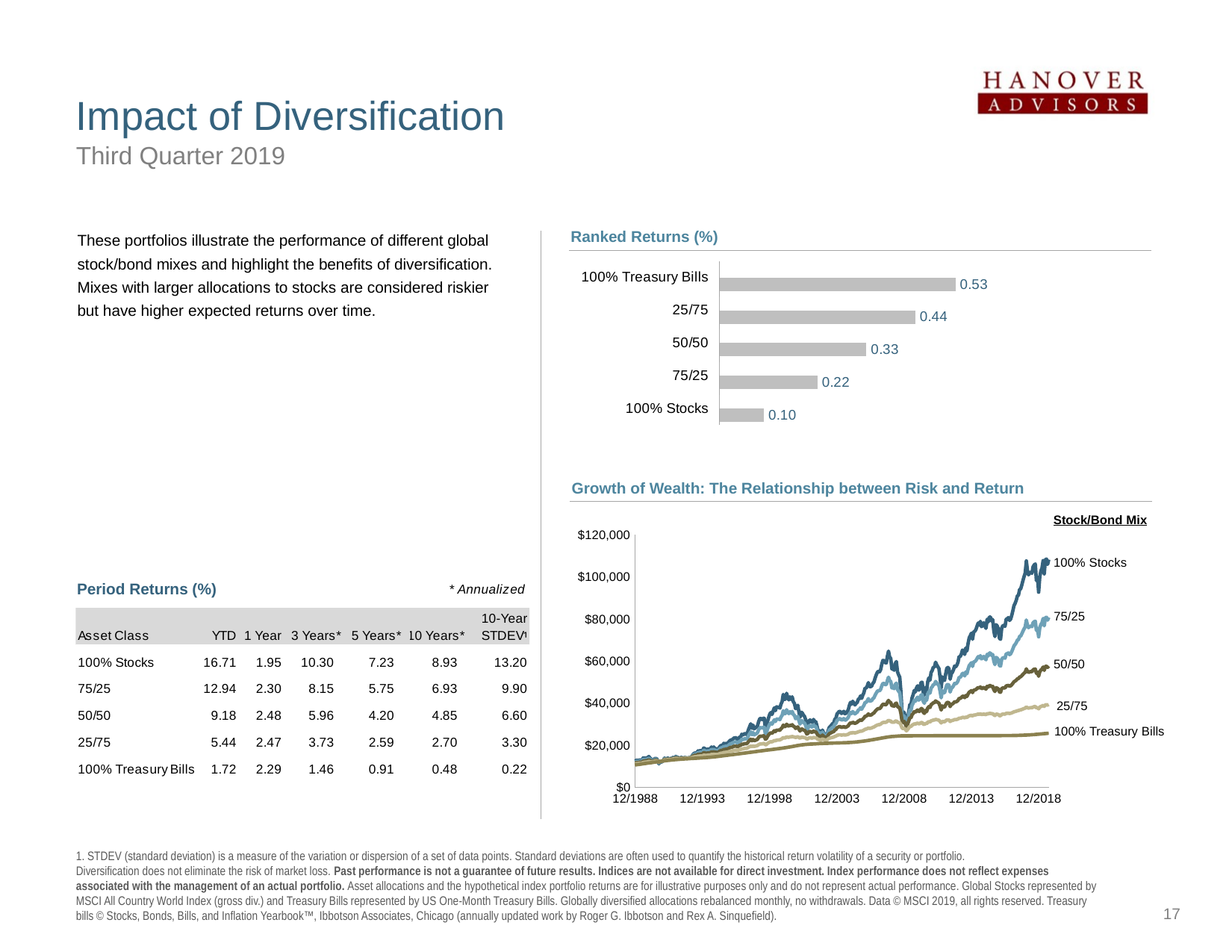
In the Ranked Returns (%) chart, what is the value for 100% Stocks? 0.10 In the Ranked Returns (%) chart, which category has the highest value? 100% Treasury Bills In the Growth of Wealth chart, is the value for 100% Treasury Bills at 12/2018 greater or less than $40,000? less In the Ranked Returns (%) chart, what is the value for 100% Treasury Bills? 0.53 How many series are plotted in the Growth of Wealth chart? 5 What kind of chart is the Growth of Wealth chart? Line chart In the Ranked Returns (%) chart, which category has the lowest value? 100% Stocks How many categories are shown in the Ranked Returns (%) chart? 5 In the Ranked Returns (%) chart, what is the value for 50/50? 0.33 What kind of chart is the Ranked Returns (%) chart? Bar chart In the Ranked Returns (%) chart, what is the difference between the values for 25/75 and 75/25? 0.22 In the Ranked Returns (%) chart, which is larger, the value for 50/50 or the value for 75/25? 50/50